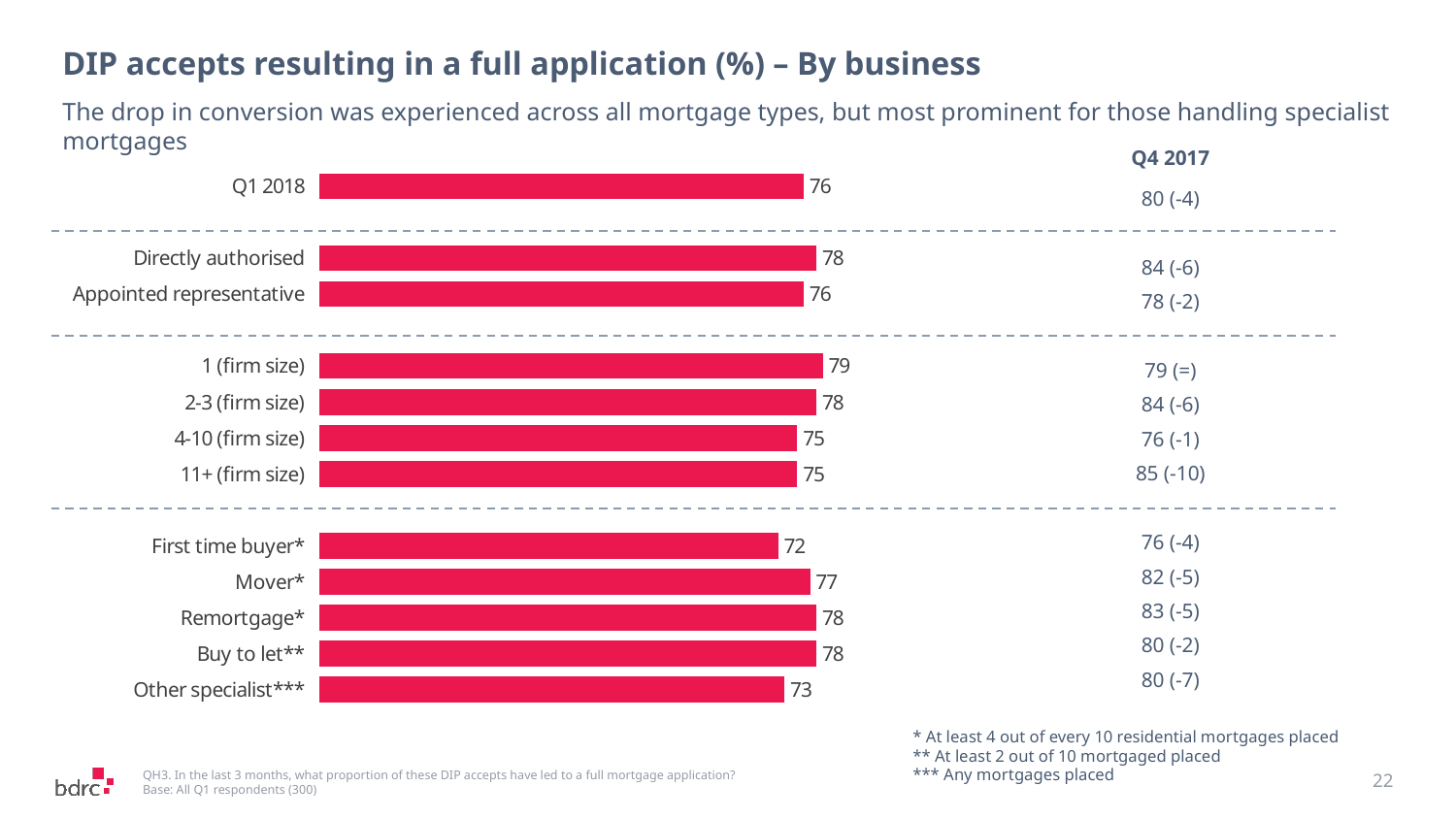
What is the Q4 2017 value shown for 11+ (firm size)? 85 (-10) What is the value for Other specialist***? 73 Which category has the lowest value? First time buyer* Which category has the highest value? 1 (firm size) What kind of chart is shown on the slide? Bar chart What is the value for Directly authorised? 78 What is the difference between the values for Mover* and First time buyer*? 5 What is the value for First time buyer*? 72 Which is larger, the value for 2-3 (firm size) or 4-10 (firm size)? 2-3 (firm size) How many categories are plotted in the chart? 12 What is the value for Q1 2018 overall? 76 What is the title of the chart? DIP accepts resulting in a full application (%) – By business